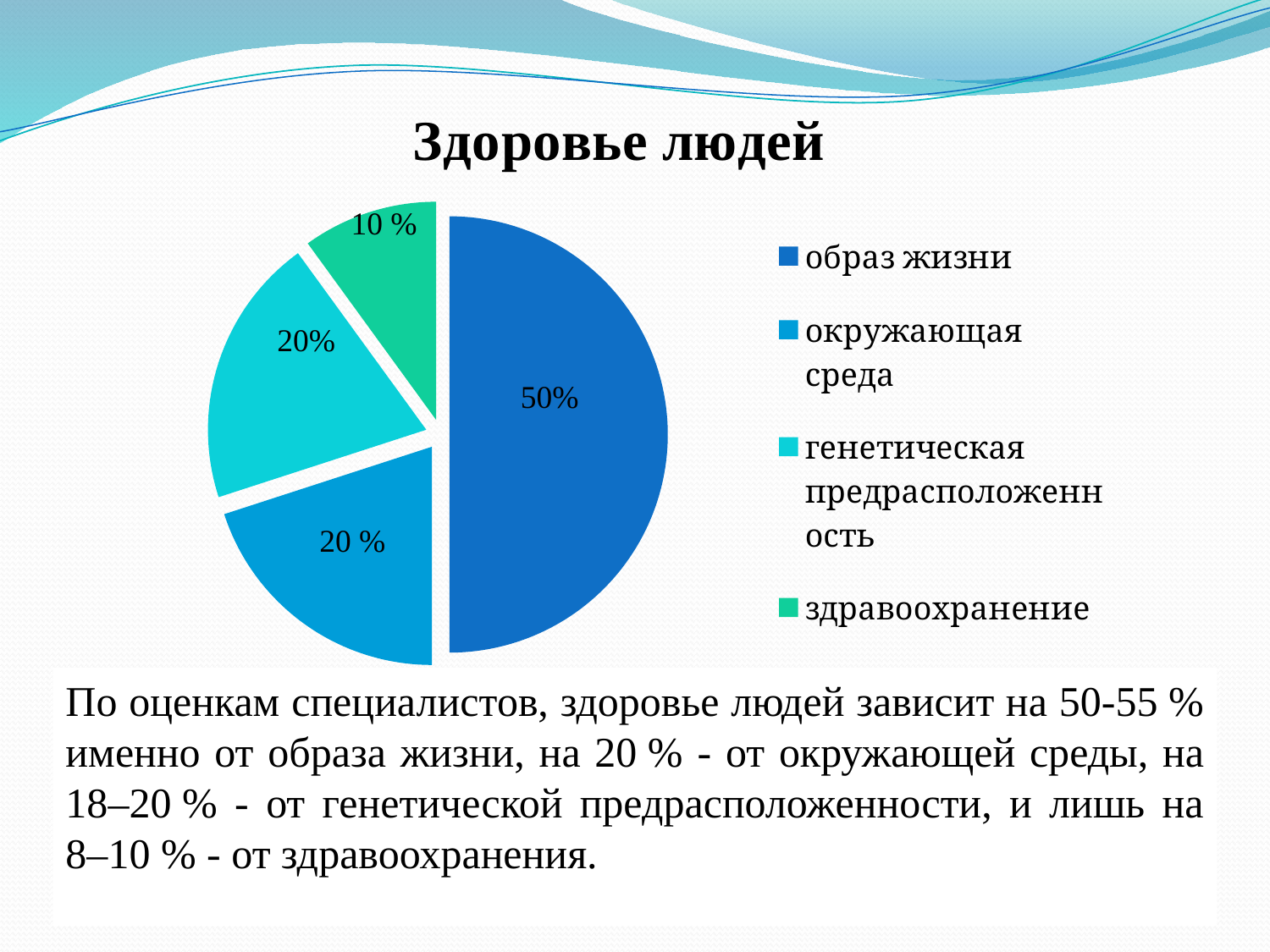
Which is larger, the slice for образ жизни or the slice for здравоохранение? образ жизни How many entries does the legend list? 4 What share of the pie is labelled for здравоохранение? 10 % What kind of chart is shown on the slide? pie chart What share of the pie is labelled for окружающая среда? 20 % What share of the pie is labelled for генетическая предрасположенность? 20% What is the difference in percentage points between the образ жизни slice and the здравоохранение slice? 40 What is the title of the chart? Здоровье людей Which category has the largest slice of the pie? образ жизни What share of the pie is labelled for образ жизни? 50% Which category has the smallest slice of the pie? здравоохранение How many slices does the pie chart have? 4